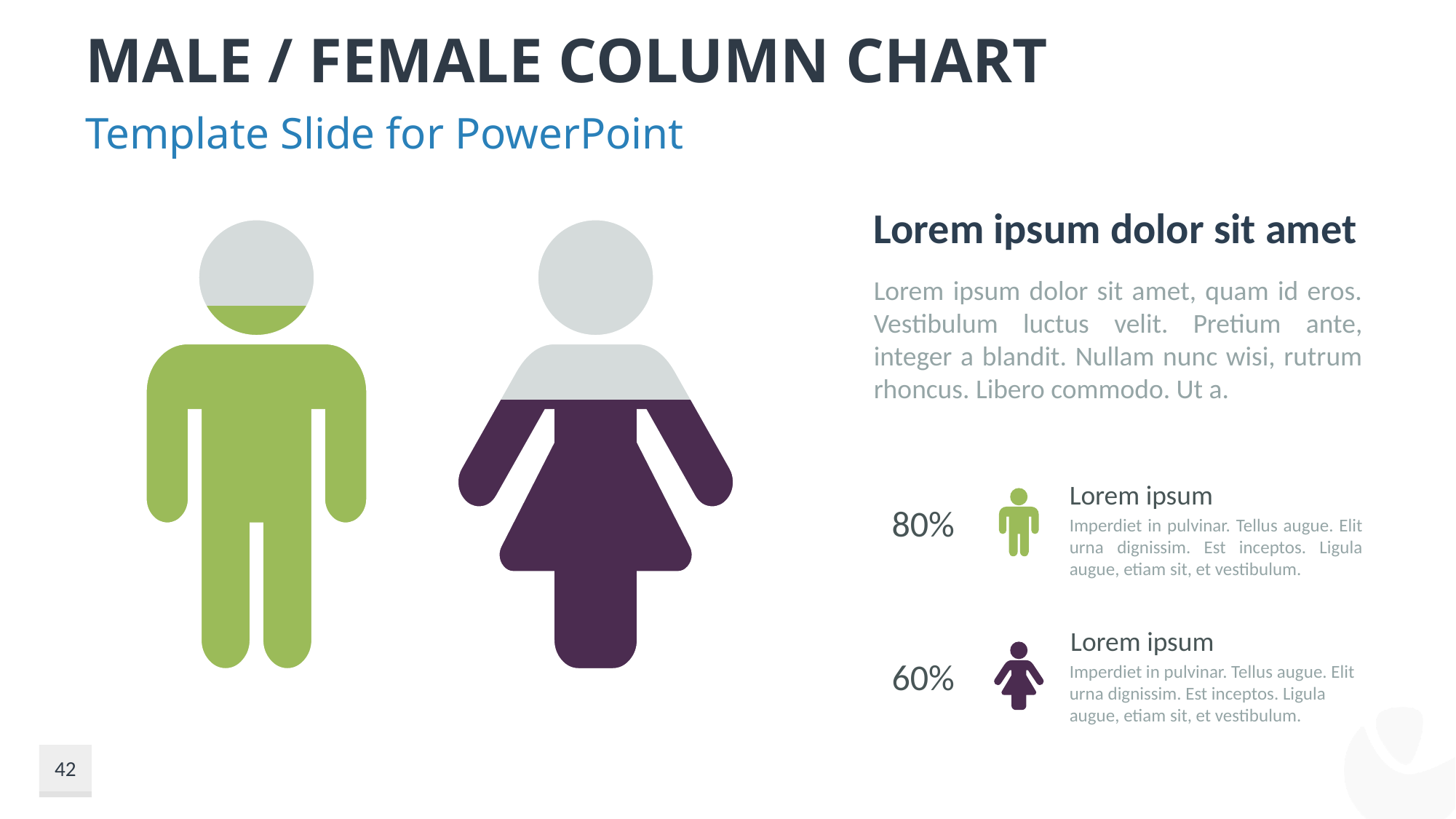
How many figures (categories) are compared on the slide? 2 Which figure, male or female, has the higher percentage? Male Which figure, male or female, has the lower percentage? Female Is the female figure's percentage larger or smaller than the male figure's? Smaller What colour is the fill of the male figure? Green What percentage is shown for the male figure? 80% What percentage is shown for the female figure? 60% What is the difference between the male percentage and the female percentage? 20% What colour is the fill of the female figure? Purple Is the value for the female figure greater or less than 50%? greater What kind of chart is used to show the male and female values? Pictogram (icon) chart